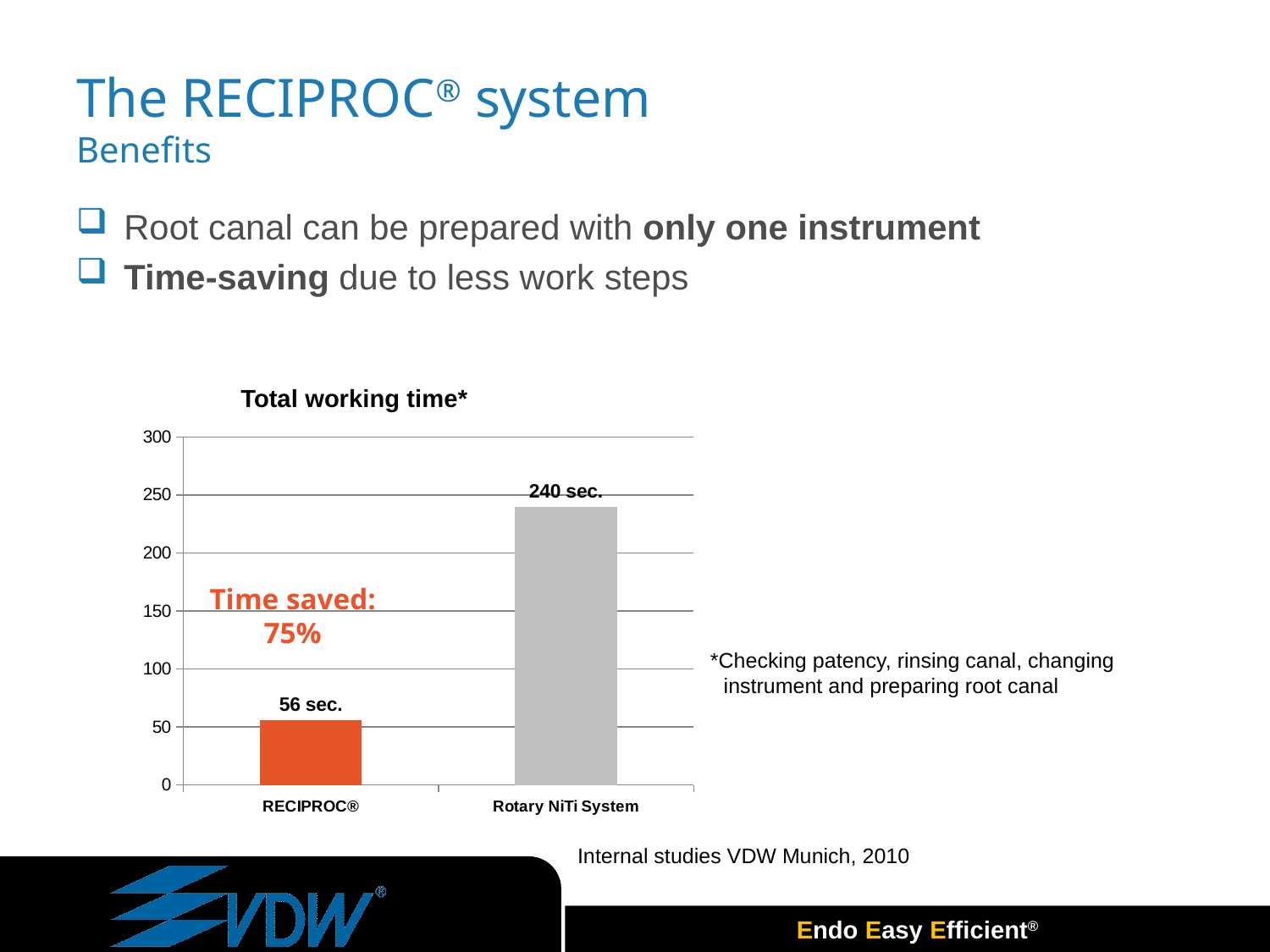
Which category has the highest total working time? Rotary NiTi System What kind of chart is shown on the slide? Bar chart Which category has the lowest total working time? RECIPROC® What is the total working time for the Rotary NiTi System? 240 sec. Is the value for RECIPROC® greater or less than 100? less How many categories are shown in the chart? 2 What is the title of the chart? Total working time* What is the total working time for RECIPROC®? 56 sec. What is the difference in working time between the Rotary NiTi System and RECIPROC®? 184 sec. Is the value for the Rotary NiTi System greater or less than 200? greater What percentage of time saved is annotated on the chart? 75% Which has a larger total working time, RECIPROC® or the Rotary NiTi System? Rotary NiTi System